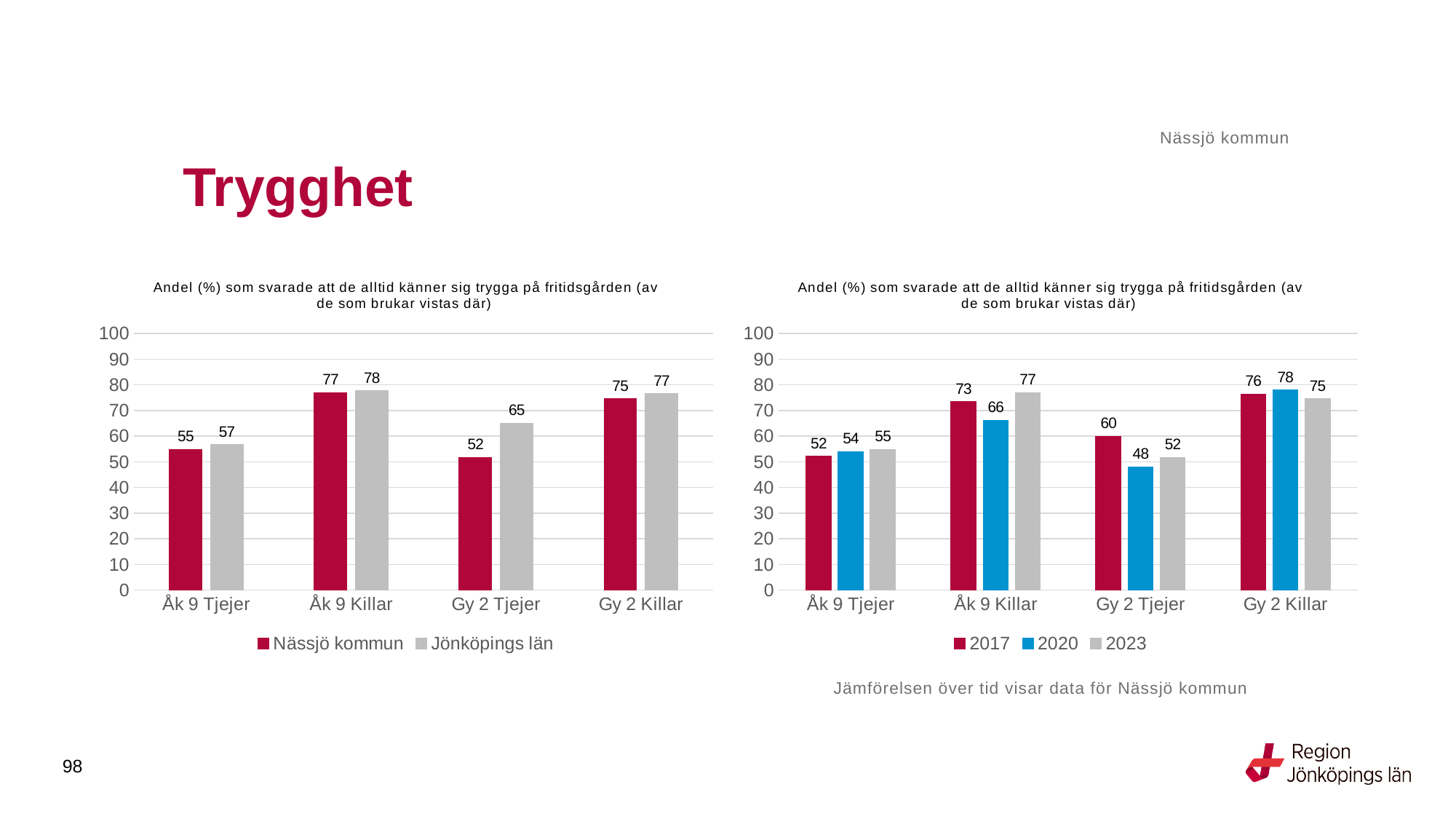
In the right chart, is the value for 2023 for Åk 9 Killar larger than the value for 2020 for Åk 9 Killar? Yes In the right chart, how many series does the legend list? 3 In the right chart, what is the difference between the 2017 and 2023 values for Gy 2 Tjejer? 8 In the right chart, which category has the lowest value for 2020? Gy 2 Tjejer In the left chart, how many series does the legend list? 2 In the right chart, what is the value for 2017 for Åk 9 Killar? 73 In the left chart, what is the value for Nässjö kommun for Gy 2 Tjejer? 52 In the left chart, what is the difference between Jönköpings län and Nässjö kommun for Gy 2 Tjejer? 13 What kind of chart is the right chart? Bar chart In the right chart, what is the value for 2020 for Gy 2 Tjejer? 48 In the left chart, what is the value for Jönköpings län for Åk 9 Killar? 78 In the left chart, which category has the highest value for Nässjö kommun? Åk 9 Killar